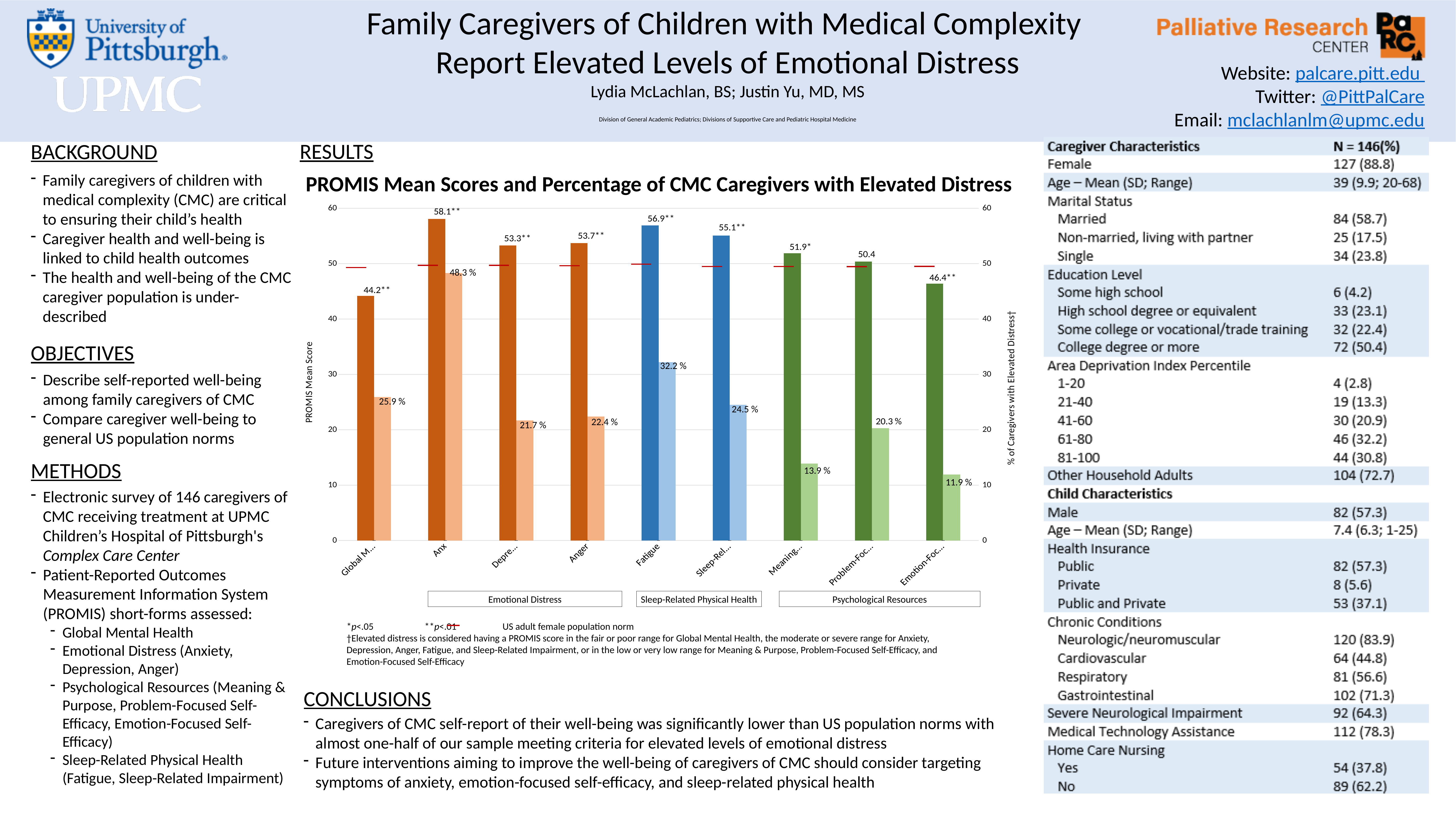
What is the highest percentage of caregivers with elevated distress shown on the chart? 48.3 % What is the difference between the PROMIS mean scores for Fatigue and Anger? 3.2 Which has a higher percentage of caregivers with elevated distress, Fatigue or Anger? Fatigue What is the PROMIS mean score for Anger? 53.7 What are the three group labels shown beneath the x axis of the chart? Emotional Distress, Sleep-Related Physical Health, Psychological Resources What is the lowest percentage of caregivers with elevated distress shown on the chart? 11.9 % How many categories are plotted along the x axis of the chart? 9 What percentage of caregivers had elevated distress for Fatigue? 32.2 % Which category has the highest PROMIS mean score? Anx What is the PROMIS mean score for Fatigue? 56.9 What percentage of caregivers had elevated distress for Anger? 22.4 % What type of chart is shown under the title 'PROMIS Mean Scores and Percentage of CMC Caregivers with Elevated Distress'? bar chart